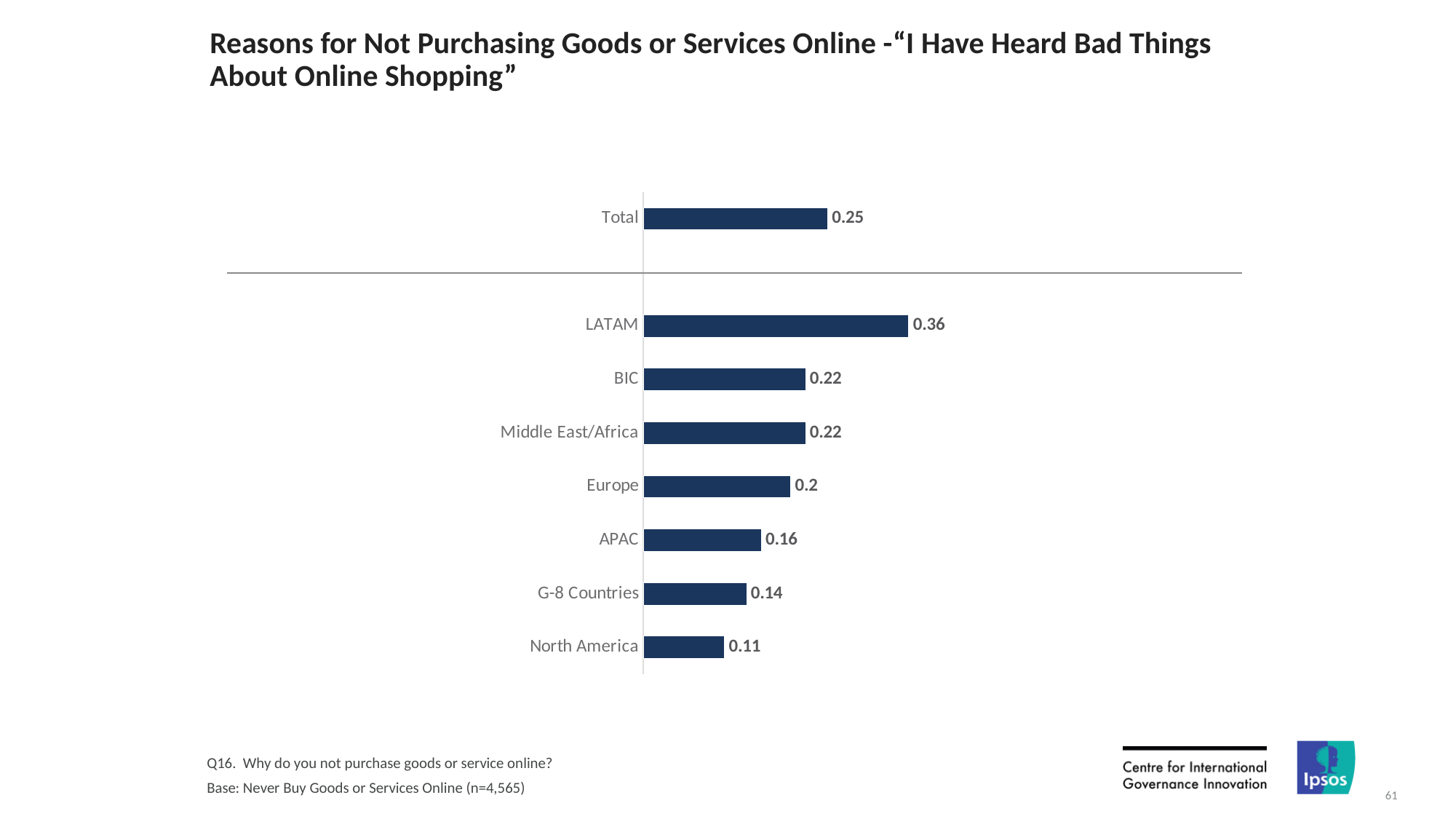
Which region has the highest value? LATAM What is the value for the Total bar? 0.25 What is the value for Europe? 0.2 What is the value for LATAM? 0.36 What is the difference between the values for APAC and G-8 Countries? 0.02 What is the difference between the values for LATAM and North America? 0.25 How many bars are plotted on the chart, including Total? 8 Which region has the lowest value? North America What is the base sample size (n) stated at the bottom of the slide? n=4,565 What kind of chart is shown on the slide? Bar chart What is the value for North America? 0.11 Which is larger, the value for Europe or the value for APAC? Europe